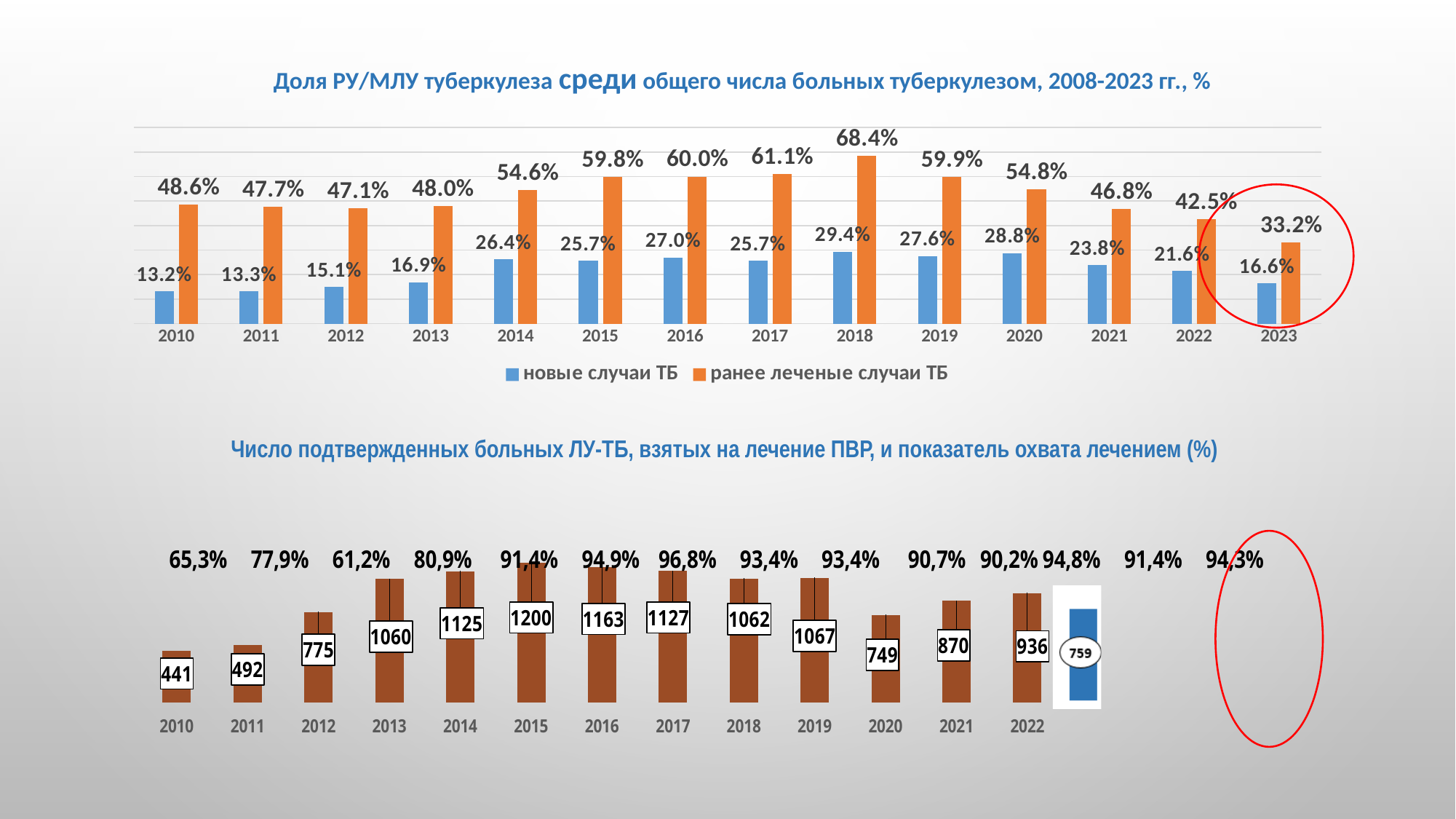
In the bottom chart, which year has the lowest number of patients? 2010 In the top chart, what is the difference between ранее леченые случаи ТБ and новые случаи ТБ in 2014? 28.2% In the top chart, which year has the lowest value for новые случаи ТБ? 2010 In the bottom chart, what is the treatment coverage percentage shown for 2017? 96,8% In the top chart, what is the value for ранее леченые случаи ТБ in 2023? 33.2% How many series does the legend of the top chart list? 2 How many years are shown on the x axis of the top chart? 14 What kind of chart is the bottom chart? bar chart In the top chart, which is larger in 2022: новые случаи ТБ or ранее леченые случаи ТБ? ранее леченые случаи ТБ In the top chart, which year has the highest value for ранее леченые случаи ТБ? 2018 In the top chart, what is the value for новые случаи ТБ in 2018? 29.4% In the bottom chart, what is the number of patients for 2015? 1200